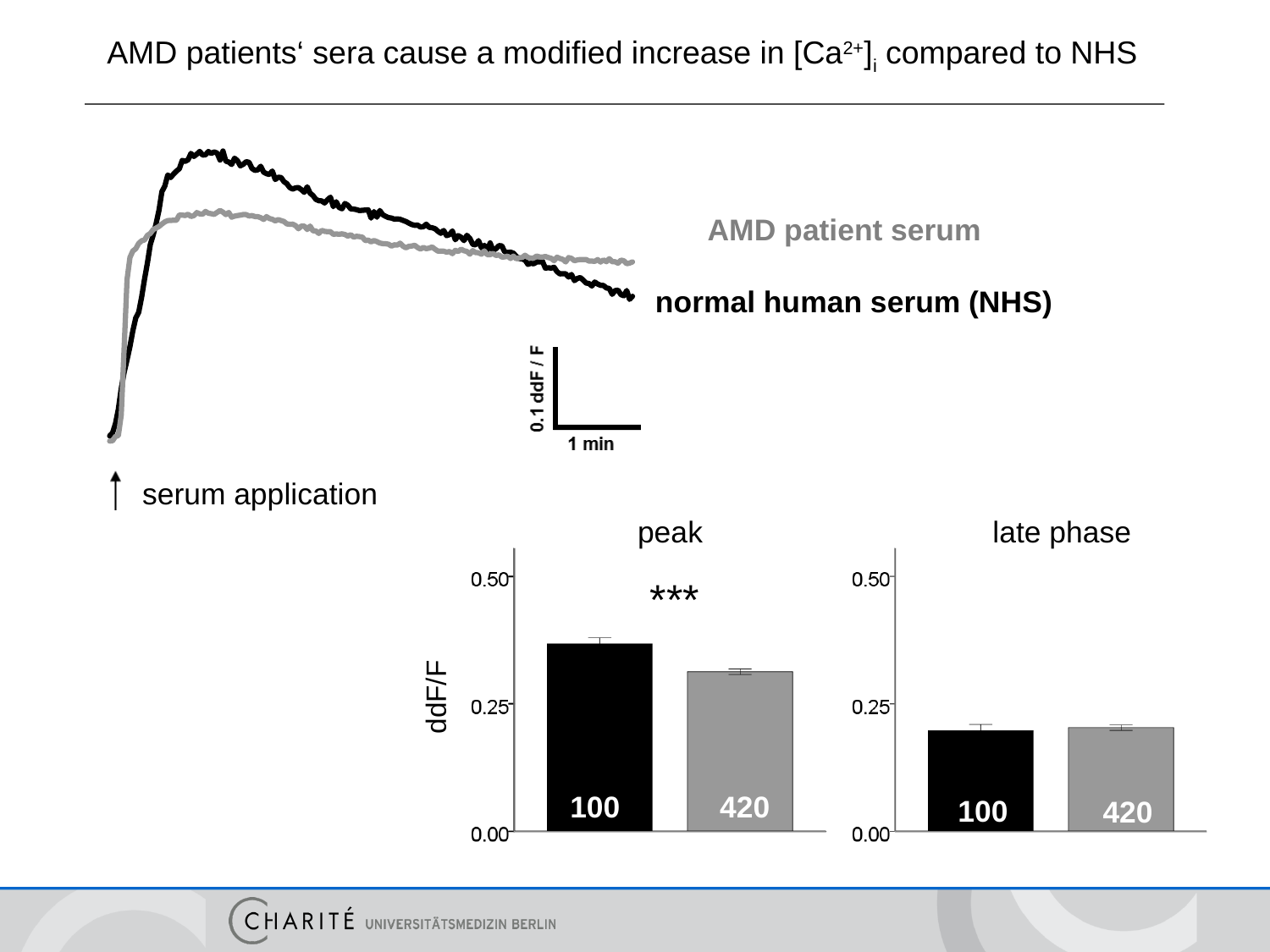
In the line trace chart at the top, do the traces rise or fall after reaching their peak? fall In the 'peak' chart, is the value of the grey bar greater or less than 0.25? greater In the line trace chart at the top, which trace reaches the higher peak, the black (NHS) trace or the grey (AMD patient serum) trace? the black (NHS) trace In the 'late phase' chart, is the value of the black bar greater or less than 0.25? less In the 'peak' chart, which bar has the highest value? the black bar (labelled 100) In the 'peak' chart, is the value of the black bar greater or less than 0.25? greater What number is printed inside the grey bar of the 'peak' chart? 420 In the 'peak' chart, which bar is taller, the black bar or the grey bar? the black bar What is the y-axis label of the 'peak' bar chart? ddF/F How many bars are shown in the 'peak' chart? 2 What kind of chart is the 'peak' chart? bar chart In the line trace chart at the top, which colour represents the AMD patient serum? grey